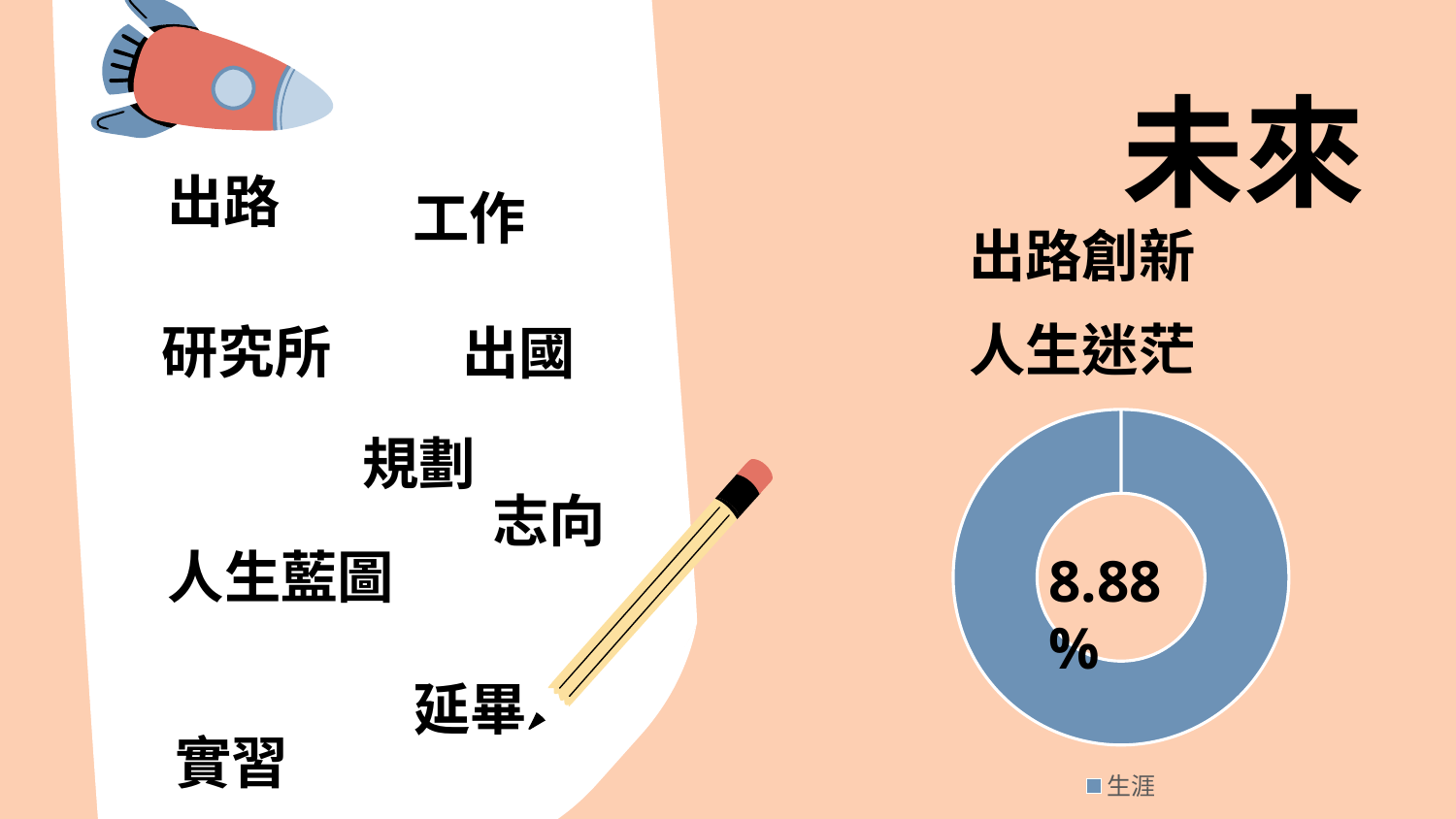
What colour is the ring of the doughnut chart? blue How many series does the legend of the doughnut chart list? 1 What kind of chart is shown on the right side of the slide? doughnut chart What percentage value is displayed in the center of the doughnut chart? 8.88% What is the name of the series listed in the legend of the doughnut chart? 生涯